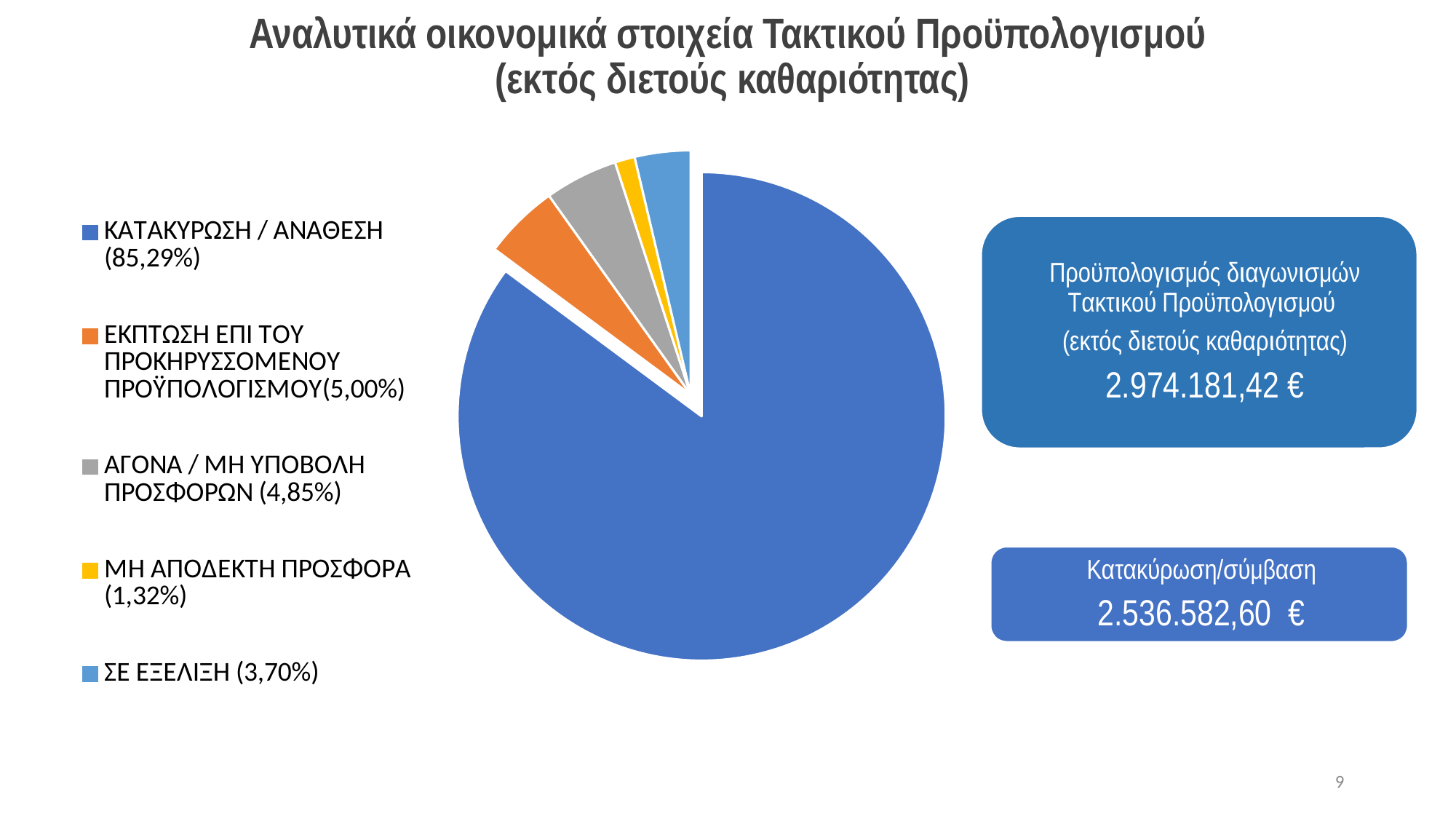
Which category has the smallest slice of the pie? ΜΗ ΑΠΟΔΕΚΤΗ ΠΡΟΣΦΟΡΑ Which is larger: the share for ΣΕ ΕΞΕΛΙΞΗ or the share for ΜΗ ΑΠΟΔΕΚΤΗ ΠΡΟΣΦΟΡΑ? ΣΕ ΕΞΕΛΙΞΗ What share of the pie does ΚΑΤΑΚΥΡΩΣΗ / ΑΝΑΘΕΣΗ represent? 85,29% What share of the pie does ΑΓΟΝΑ / ΜΗ ΥΠΟΒΟΛΗ ΠΡΟΣΦΟΡΩΝ represent? 4,85% What is the difference in percentage points between ΚΑΤΑΚΥΡΩΣΗ / ΑΝΑΘΕΣΗ and ΕΚΠΤΩΣΗ ΕΠΙ ΤΟΥ ΠΡΟΚΗΡΥΣΣΟΜΕΝΟΥ ΠΡΟΫΠΟΛΟΓΙΣΜΟΥ? 80,29% What is the difference in percentage points between ΣΕ ΕΞΕΛΙΞΗ and ΜΗ ΑΠΟΔΕΚΤΗ ΠΡΟΣΦΟΡΑ? 2,38% What colour is the slice for ΕΚΠΤΩΣΗ ΕΠΙ ΤΟΥ ΠΡΟΚΗΡΥΣΣΟΜΕΝΟΥ ΠΡΟΫΠΟΛΟΓΙΣΜΟΥ? Orange What kind of chart is shown on the slide? Pie chart What share of the pie does ΜΗ ΑΠΟΔΕΚΤΗ ΠΡΟΣΦΟΡΑ represent? 1,32% Which category has the largest slice of the pie? ΚΑΤΑΚΥΡΩΣΗ / ΑΝΑΘΕΣΗ How many slices does the pie chart have? 5